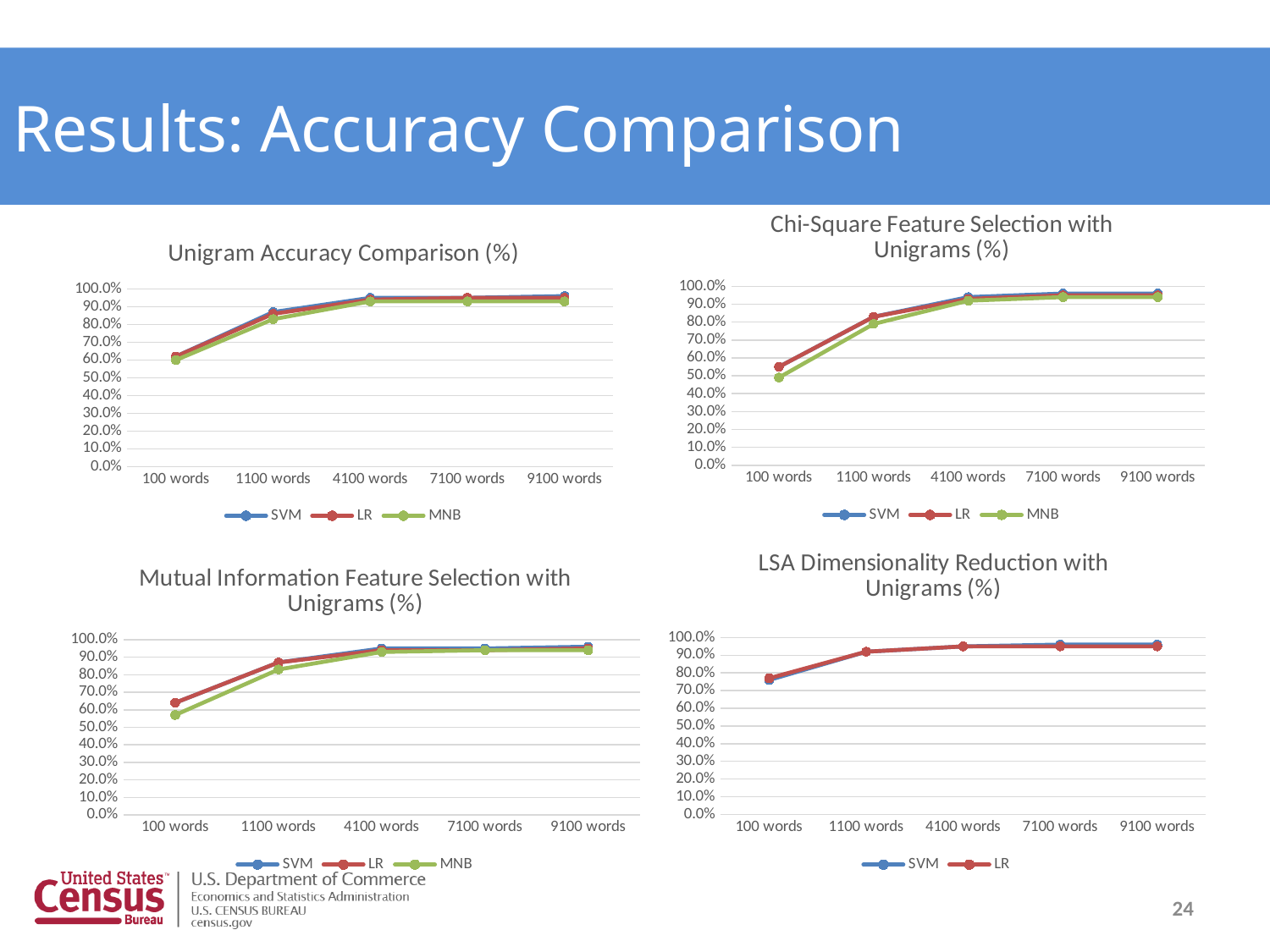
In the 'Mutual Information Feature Selection with Unigrams (%)' chart, does the SVM line rise or fall from 100 words to 9100 words? rise In the 'LSA Dimensionality Reduction with Unigrams (%)' chart, is the SVM value at 100 words greater or less than 70.0%? greater In the 'Chi-Square Feature Selection with Unigrams (%)' chart, is the MNB value at 100 words greater or less than 60.0%? less What are the legend entries of the 'Mutual Information Feature Selection with Unigrams (%)' chart? SVM, LR, MNB What type of chart is the 'Unigram Accuracy Comparison (%)' chart? line chart In the 'Chi-Square Feature Selection with Unigrams (%)' chart, which series is lowest at 100 words? MNB In the 'Unigram Accuracy Comparison (%)' chart, how many series does the legend list? 3 Which chart on the slide does not include an MNB series? LSA Dimensionality Reduction with Unigrams (%) In the 'Unigram Accuracy Comparison (%)' chart, is the MNB value at 1100 words greater or less than 90.0%? less In the 'Mutual Information Feature Selection with Unigrams (%)' chart, which is larger at 100 words, LR or MNB? LR In the 'LSA Dimensionality Reduction with Unigrams (%)' chart, how many series does the legend list? 2 In the 'Chi-Square Feature Selection with Unigrams (%)' chart, how many categories are on the x axis? 5